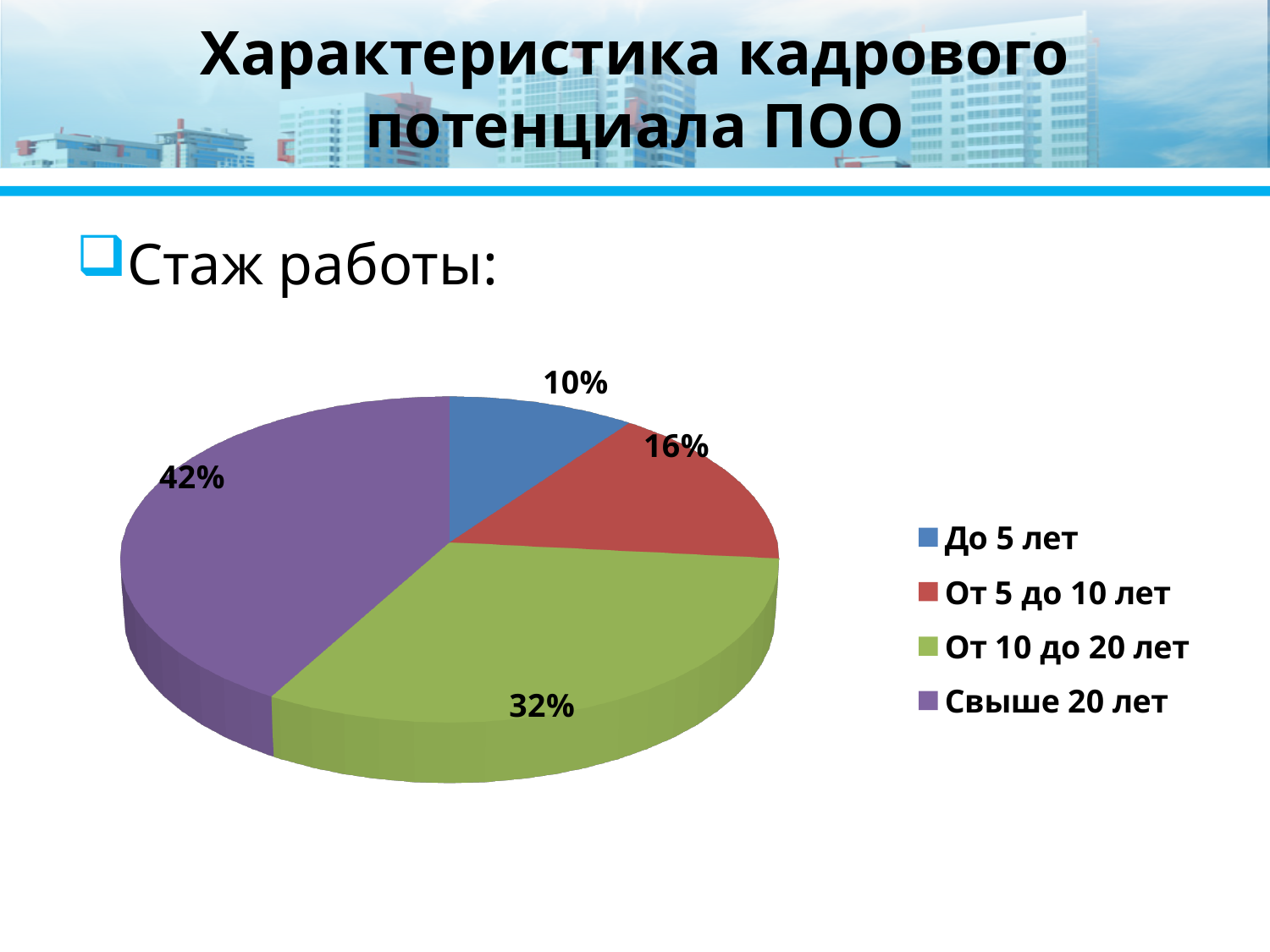
What share of the pie does the 'Свыше 20 лет' slice represent? 42% What colour is the 'Свыше 20 лет' slice in the pie chart? Purple What share of the pie does the 'От 5 до 10 лет' slice represent? 16% What kind of chart is shown on the slide? Pie chart What share of the pie does the 'От 10 до 20 лет' slice represent? 32% Which category has the largest slice of the pie? Свыше 20 лет How many entries does the legend list? 4 How many categories are shown in the pie chart? 4 Which slice is larger: 'От 5 до 10 лет' or 'От 10 до 20 лет'? От 10 до 20 лет Which category has the smallest slice of the pie? До 5 лет What is the difference in percentage points between the 'Свыше 20 лет' slice and the 'От 10 до 20 лет' slice? 10